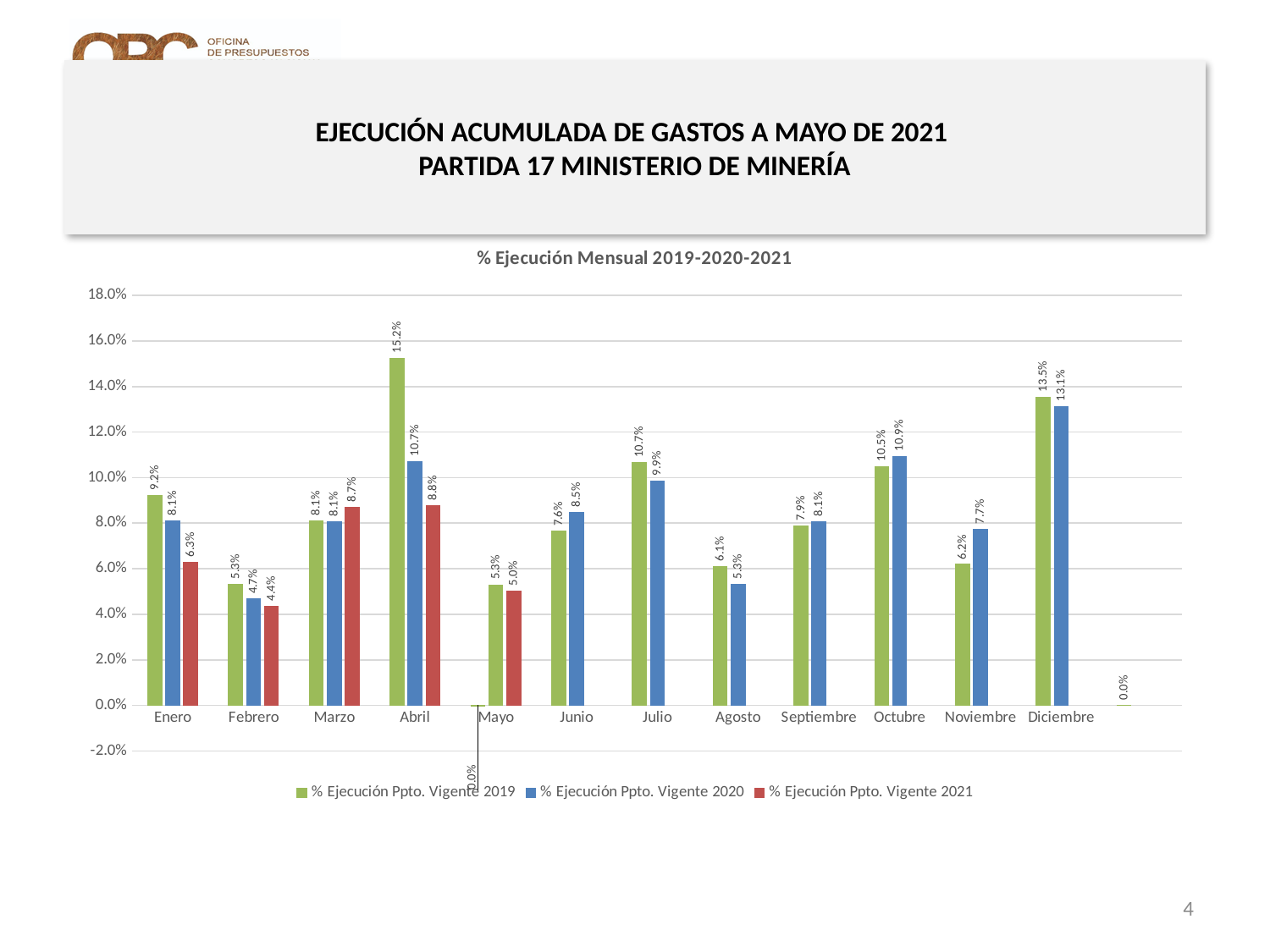
Which month has the lowest value in the % Ejecución Ppto. Vigente 2020 series? Febrero For Octubre, which series has the larger value: % Ejecución Ppto. Vigente 2019 or % Ejecución Ppto. Vigente 2020? % Ejecución Ppto. Vigente 2020 What is the difference between the 2019 and 2020 values for Abril? 4.5 percentage points Is the value for Julio in the % Ejecución Ppto. Vigente 2020 series greater or less than 8.0%? greater How many months are shown on the x axis? 12 What is the difference between the 2019 and 2020 values for Diciembre? 0.4 percentage points What is the value for Marzo in the % Ejecución Ppto. Vigente 2021 series? 8.7% Which month has the highest value in the % Ejecución Ppto. Vigente 2019 series? Abril What is the value for Abril in the % Ejecución Ppto. Vigente 2019 series? 15.2% How many series does the legend list? 3 What is the value for Enero in the % Ejecución Ppto. Vigente 2021 series? 6.3% What is the title of the chart? % Ejecución Mensual 2019-2020-2021